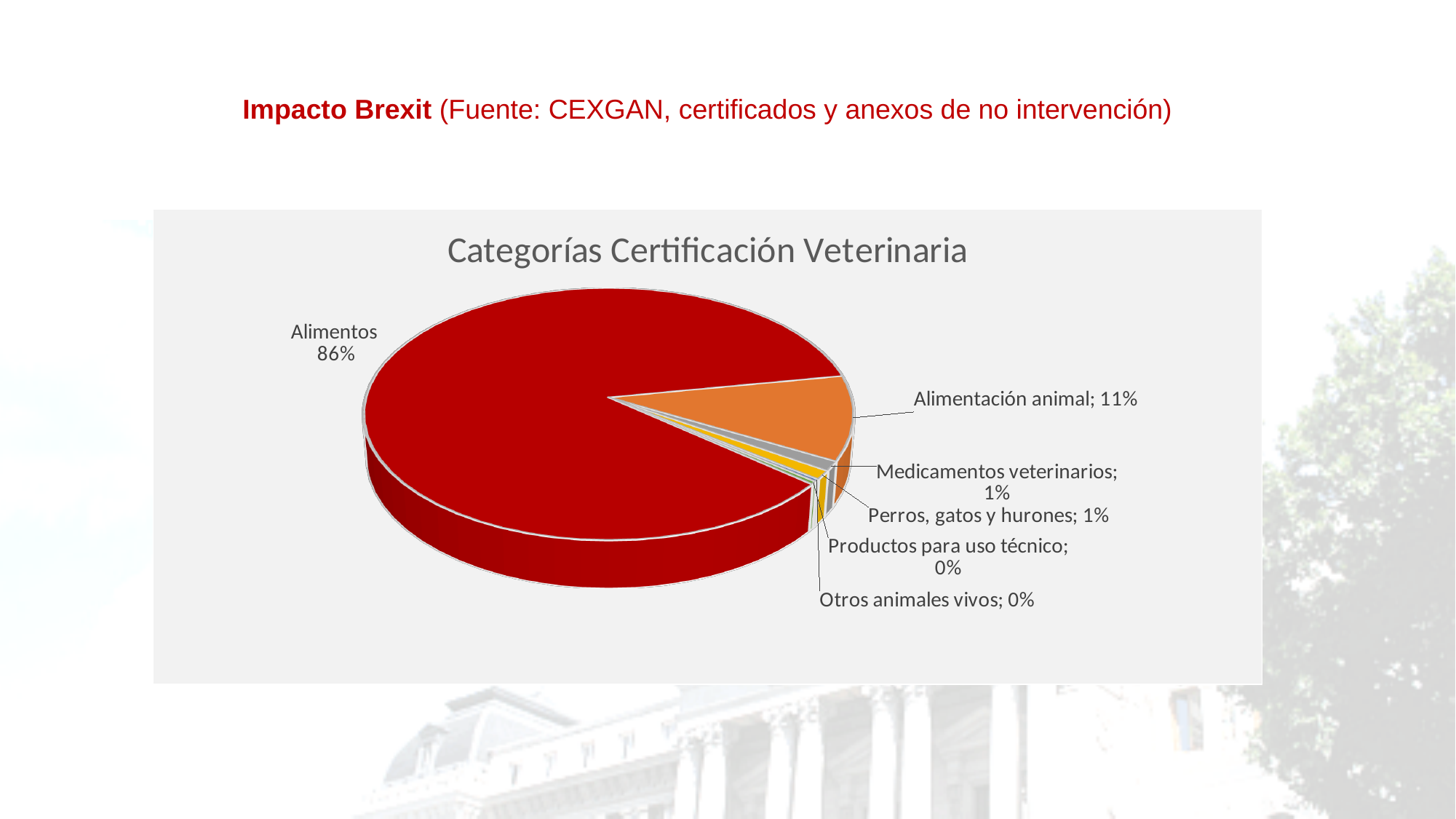
How many categories are shown in the pie chart? 6 What is the value shown for Perros, gatos y hurones? 1% What kind of chart is shown on the slide? Pie chart Which category has the largest slice of the pie? Alimentos What is the value shown for Productos para uso técnico? 0% What is the difference between the shares of Alimentos and Alimentación animal? 75% What is the value shown for Otros animales vivos? 0% What share of the pie does Alimentos represent? 86% Which is larger, the share for Alimentación animal or the share for Medicamentos veterinarios? Alimentación animal What share of the pie does Alimentación animal represent? 11% What is the value shown for Medicamentos veterinarios? 1% What is the title of the chart? Categorías Certificación Veterinaria